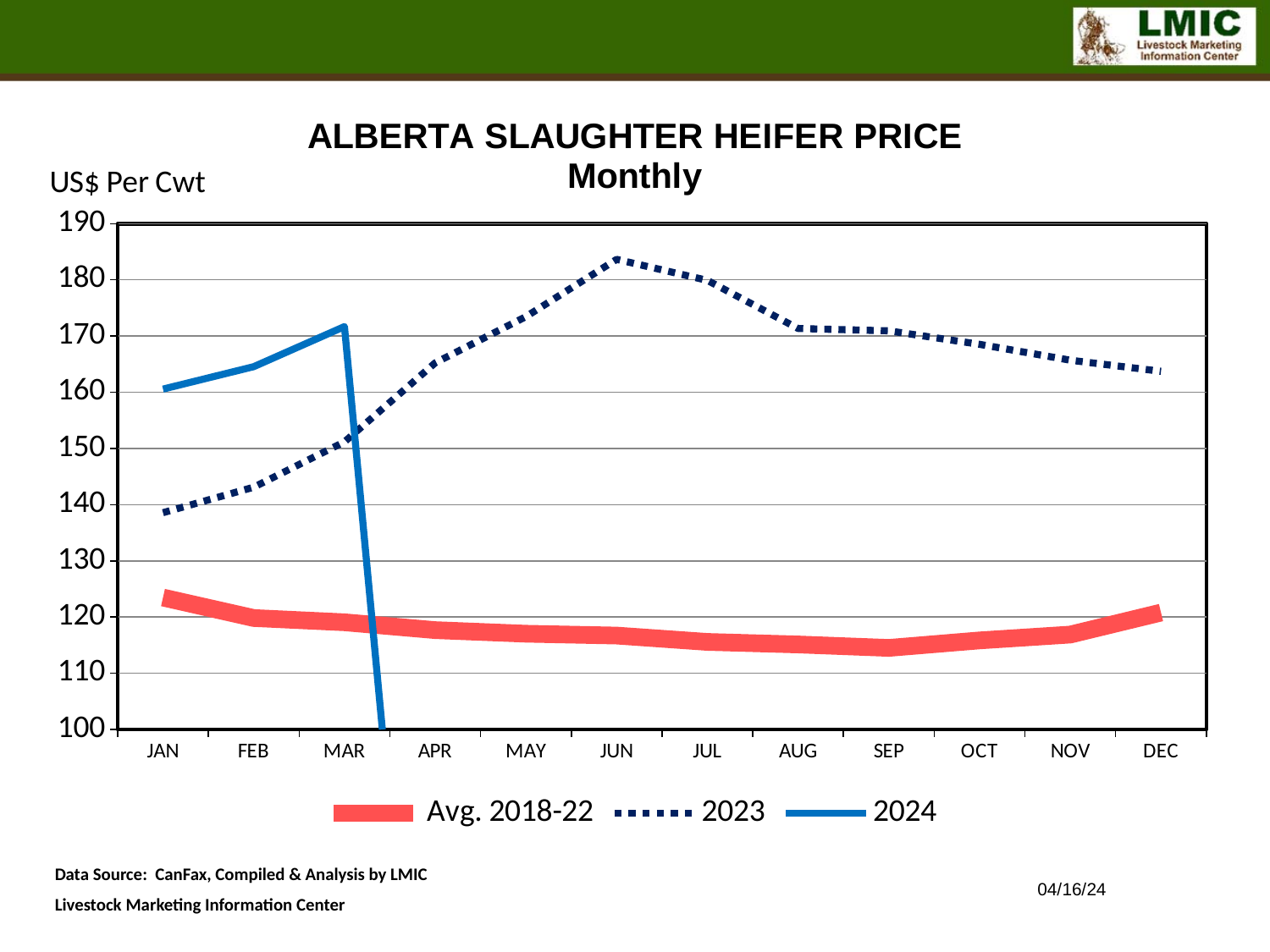
In JAN, which series has the higher value, 2024 or 2023? 2024 What kind of chart is shown on the slide? line chart In which month does the 2023 series reach its highest value? JUN What unit is shown on the y axis label? US$ Per Cwt Is the 2023 value for MAR greater or less than 160? less How many months are shown along the x axis? 12 In which month is the 2023 series at its lowest value? JAN Is the 2023 value for JUN greater or less than 180? greater Is the 2024 value for MAR greater or less than 170? greater Does the 2024 series rise or fall from JAN to MAR? rise How many series does the legend list? 3